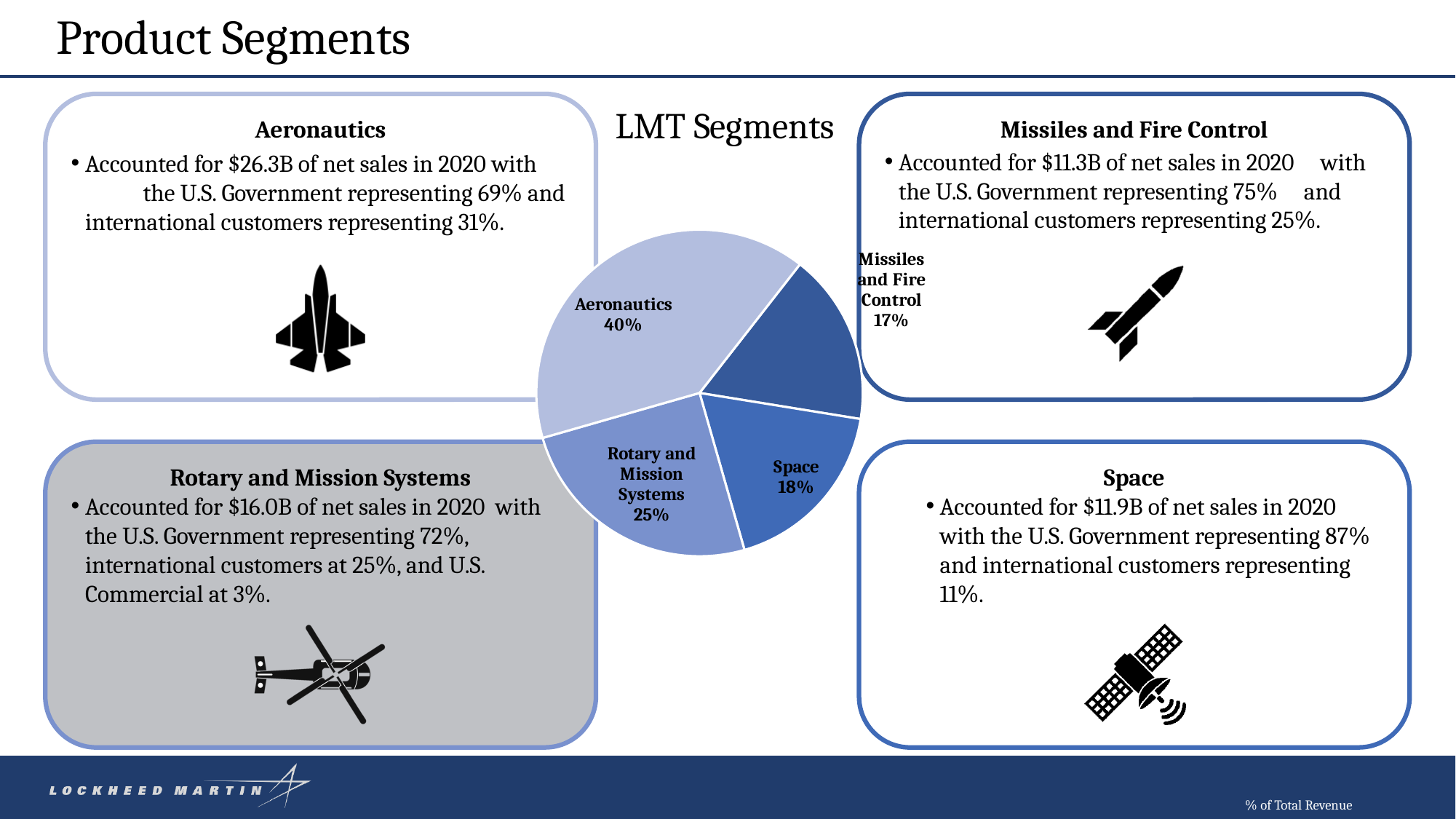
Which segment has the largest slice of the pie? Aeronautics What is the difference in percentage points between Aeronautics and Rotary and Mission Systems? 15 What share of the pie does Space represent? 18% What share of the pie does Aeronautics represent? 40% How many segments are shown in the pie chart? 4 What is the combined share of Space and Missiles and Fire Control? 35% What type of chart is shown on the slide? Pie chart Which is larger, the Space slice or the Rotary and Mission Systems slice? Rotary and Mission Systems What share of the pie does Rotary and Mission Systems represent? 25% What share of the pie does Missiles and Fire Control represent? 17% Which segment has the smallest slice of the pie? Missiles and Fire Control What is the title of the chart? LMT Segments